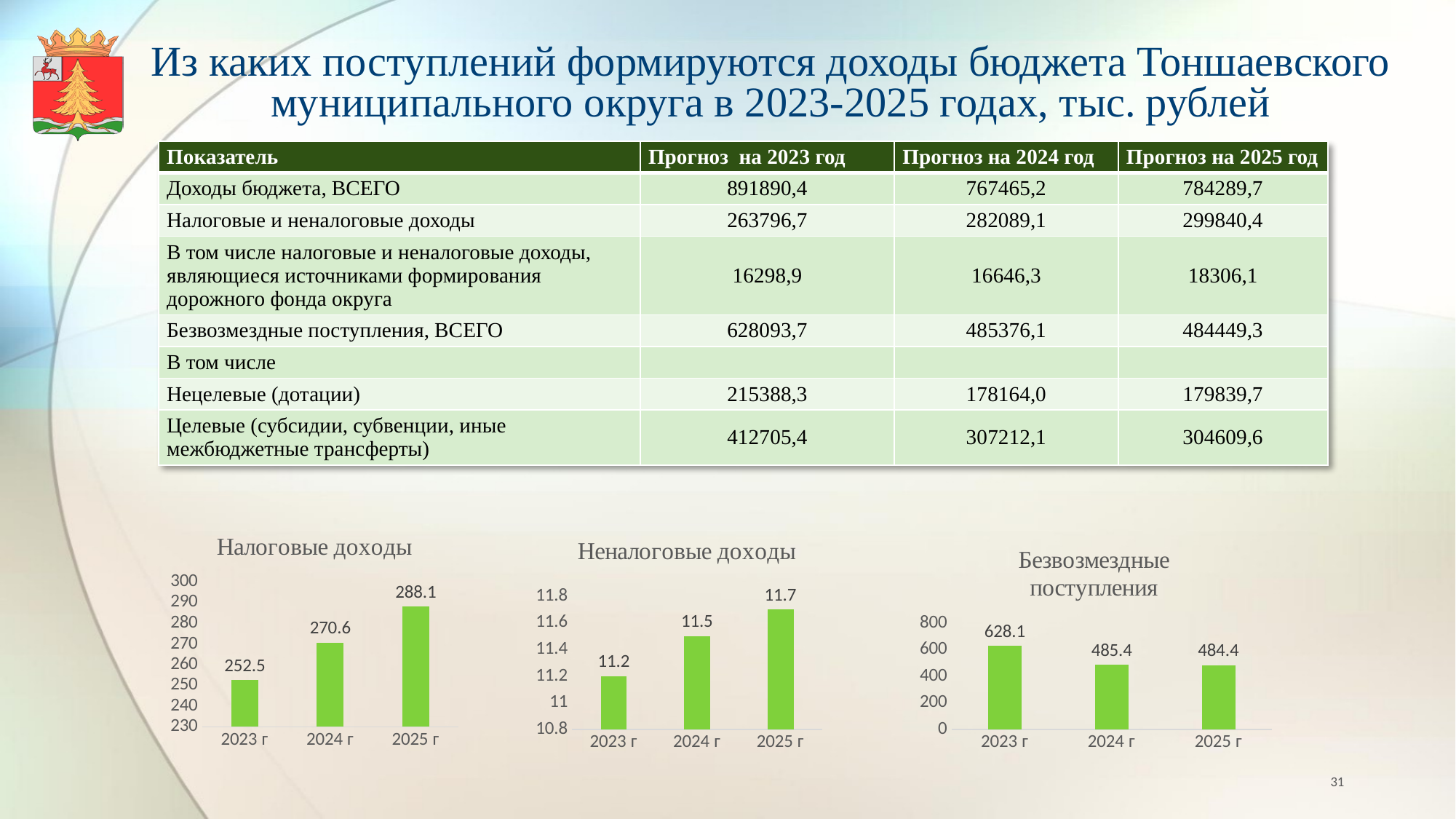
In the 'Неналоговые доходы' chart, what is the value for 2024 г? 11.5 In the 'Неналоговые доходы' chart, which year has the highest value? 2025 г In the 'Безвозмездные поступления' chart, what is the difference between the 2023 г and 2024 г values? 142.7 What type of chart is the 'Налоговые доходы' chart? bar chart In the 'Безвозмездные поступления' chart, is the value for 2023 г greater or less than 600? greater In the 'Налоговые доходы' chart, what is the value for 2025 г? 288.1 In the 'Неналоговые доходы' chart, how many bars are plotted? 3 In the 'Безвозмездные поступления' chart, which is larger, the value for 2024 г or 2025 г? 2024 г In the 'Налоговые доходы' chart, which year has the lowest value? 2023 г In the 'Налоговые доходы' chart, do the values rise or fall from 2023 г to 2025 г? rise In the 'Безвозмездные поступления' chart, what is the value for 2023 г? 628.1 In the 'Налоговые доходы' chart, what is the difference between the 2025 г and 2023 г values? 35.6